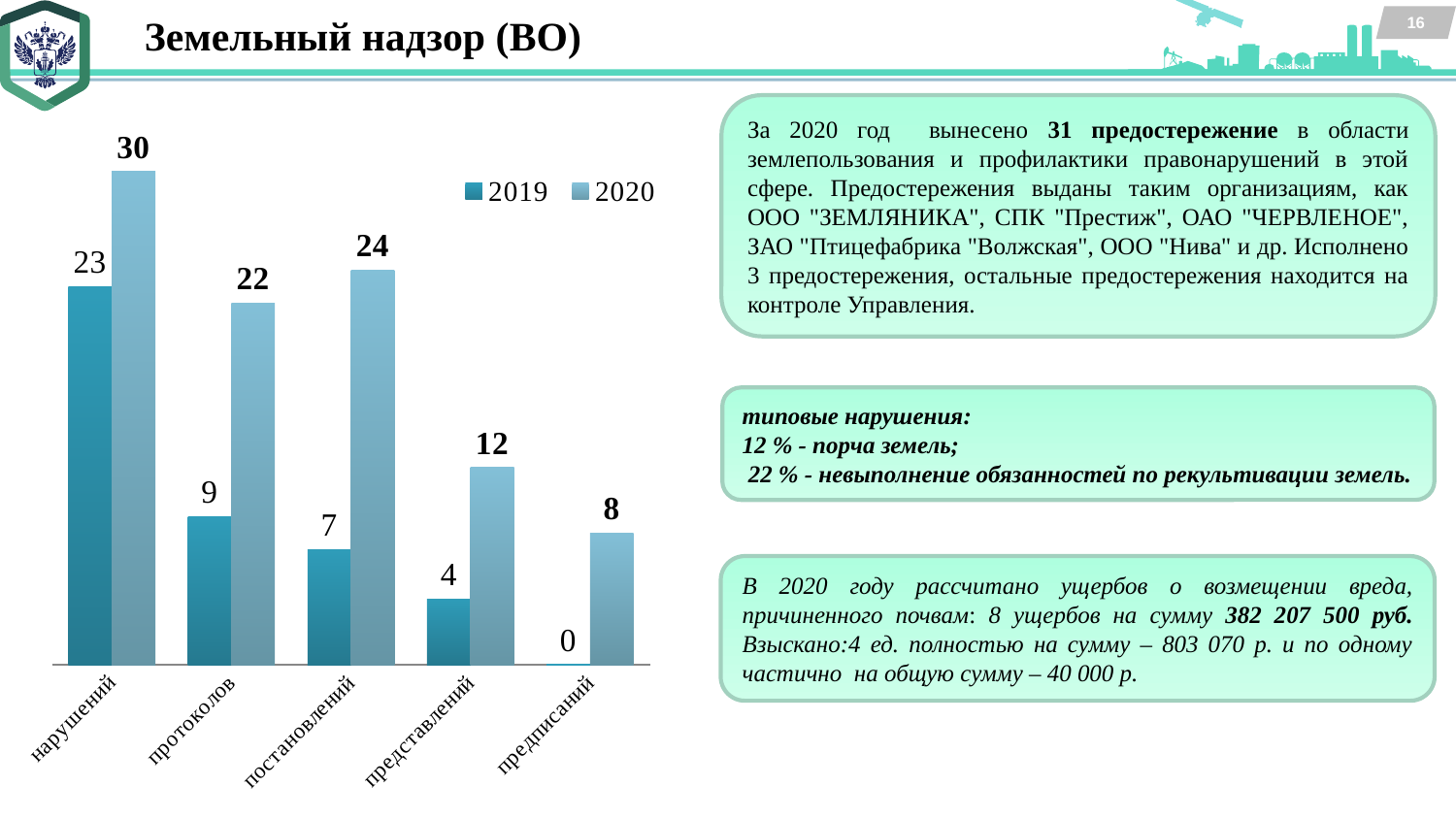
What is the value for нарушений in the 2019 series? 23 What is the difference between the 2020 and 2019 values for протоколов? 13 What is the value for постановлений in the 2020 series? 24 Which category has the highest value in the 2020 series? нарушений How many categories are shown on the x axis? 5 What is the value for предписаний in the 2019 series? 0 Which is larger: the 2020 value for постановлений or the 2020 value for протоколов? постановлений How many series does the legend list? 2 Which category has the lowest value in the 2019 series? предписаний What kind of chart is shown on the slide? bar chart What is the value for представлений in the 2020 series? 12 Which series does the legend list first? 2019